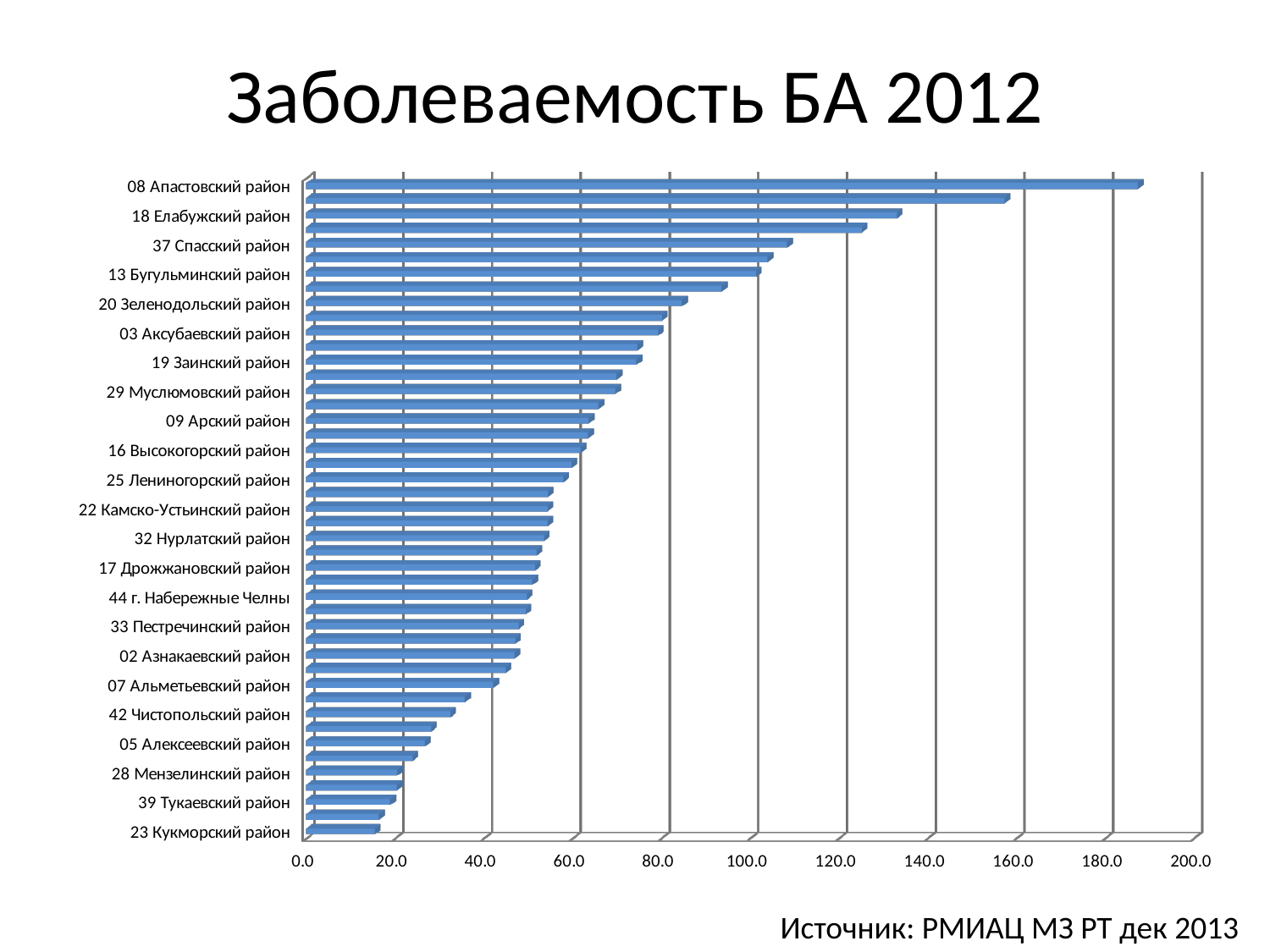
Which has the larger value, 18 Елабужский район or 37 Спасский район? 18 Елабужский район Which labeled district has the lowest value in the chart? 23 Кукморский район Do the bar values increase or decrease going from the top of the chart to the bottom? decrease Is the value for 37 Спасский район greater or less than 100? greater Is the value for 23 Кукморский район greater or less than 20? less Is the value for 08 Апастовский район greater or less than 180? greater What is the title of the chart? Заболеваемость БА 2012 What kind of chart is shown on the slide? bar chart Which labeled district has the highest value in the chart? 08 Апастовский район